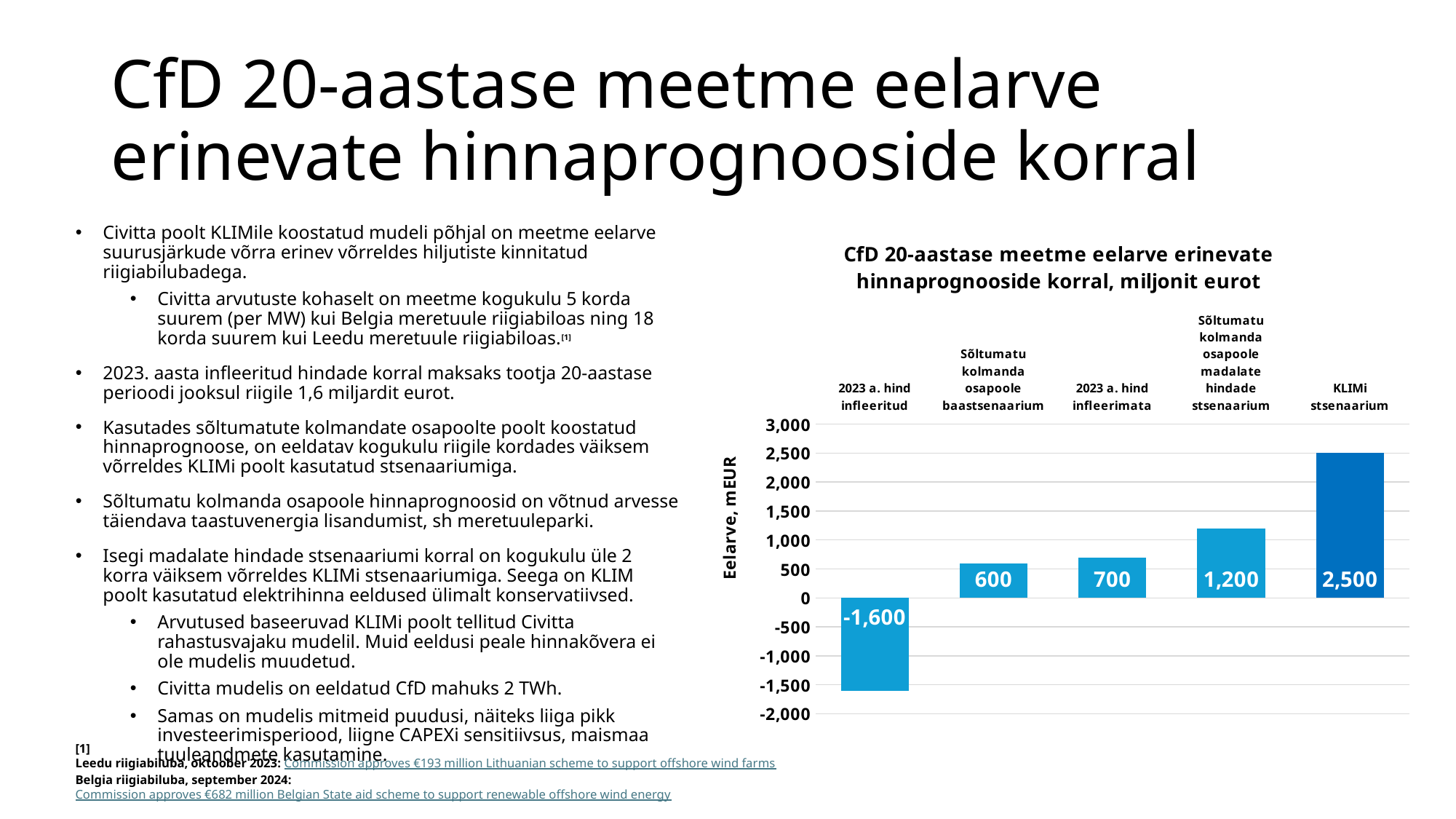
What is the difference between the "KLIMi stsenaarium" value and the "Sõltumatu kolmanda osapoole madalate hindade stsenaarium" value? 1,300 What is the value for the "Sõltumatu kolmanda osapoole madalate hindade stsenaarium" bar? 1,200 What is the label of the vertical axis of the chart? Eelarve, mEUR Which category has the lowest value? 2023 a. hind infleeritud What is the value for the "Sõltumatu kolmanda osapoole baastsenaarium" bar? 600 How many categories are shown in the chart? 5 Is the value for "2023 a. hind infleerimata" greater or less than 1,000? less Which category has the highest value? KLIMi stsenaarium What is the value for the "KLIMi stsenaarium" bar? 2,500 Which is larger: the value for "2023 a. hind infleerimata" or the value for "Sõltumatu kolmanda osapoole baastsenaarium"? 2023 a. hind infleerimata What is the value for the "2023 a. hind infleeritud" bar? -1,600 What kind of chart is shown on the slide? bar chart